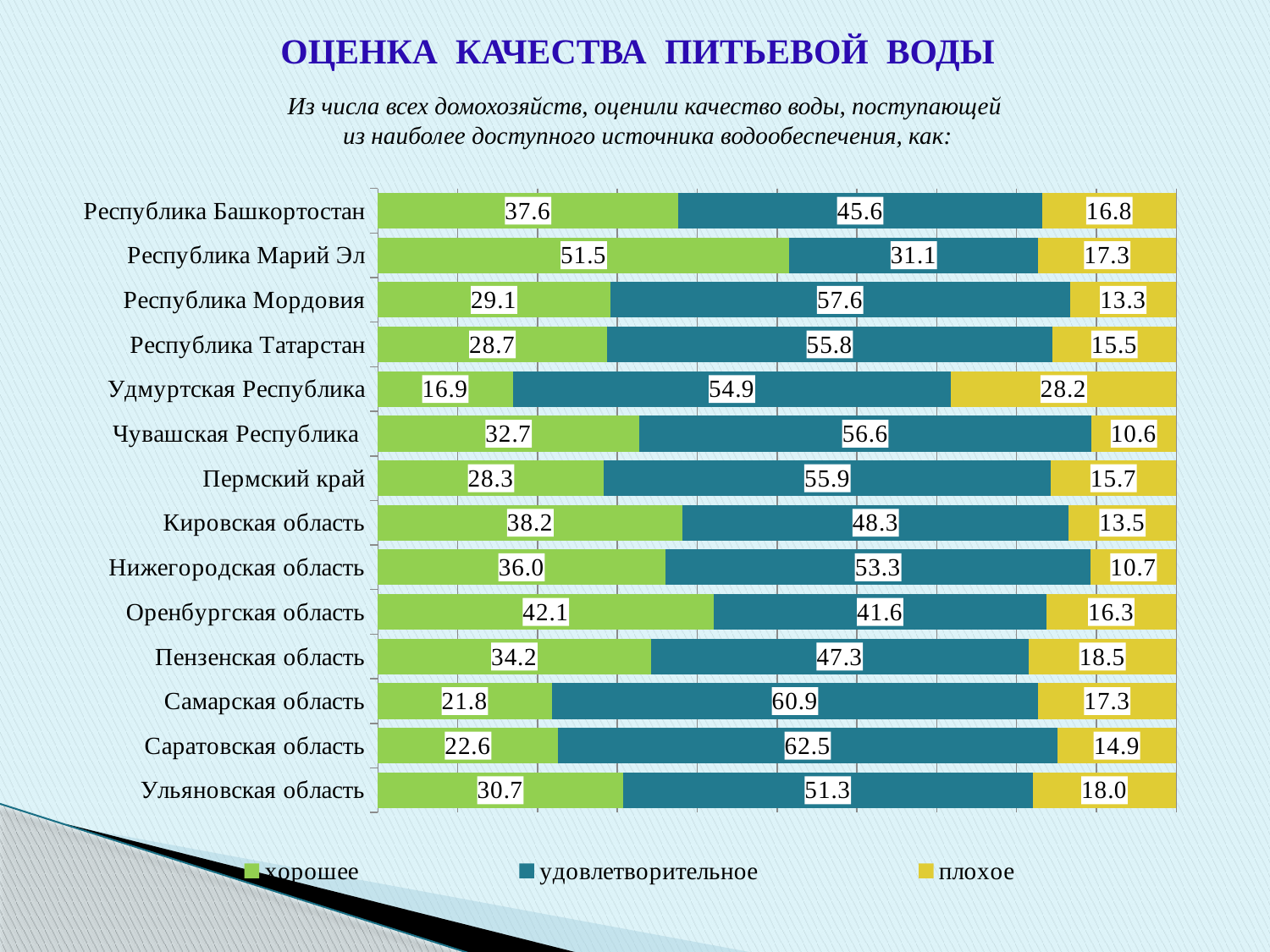
How many regions are listed on the chart? 14 Which region has the highest value for 'плохое'? Удмуртская Республика What is the value of 'плохое' for Удмуртская Республика? 28.2 How many series does the legend list? 3 Which is larger for Оренбургская область: 'хорошее' or 'удовлетворительное'? хорошее What kind of chart is shown on the slide? Stacked bar chart Which region has the lowest value for 'хорошее'? Удмуртская Республика What is the total of the stacked bar for Республика Башкортостан? 100.0 What is the difference between the 'хорошее' values for Республика Башкортостан and Удмуртская Республика? 20.7 Which region has the highest value for 'хорошее'? Республика Марий Эл What is the value of 'удовлетворительное' for Саратовская область? 62.5 What is the value of 'хорошее' for Республика Марий Эл? 51.5